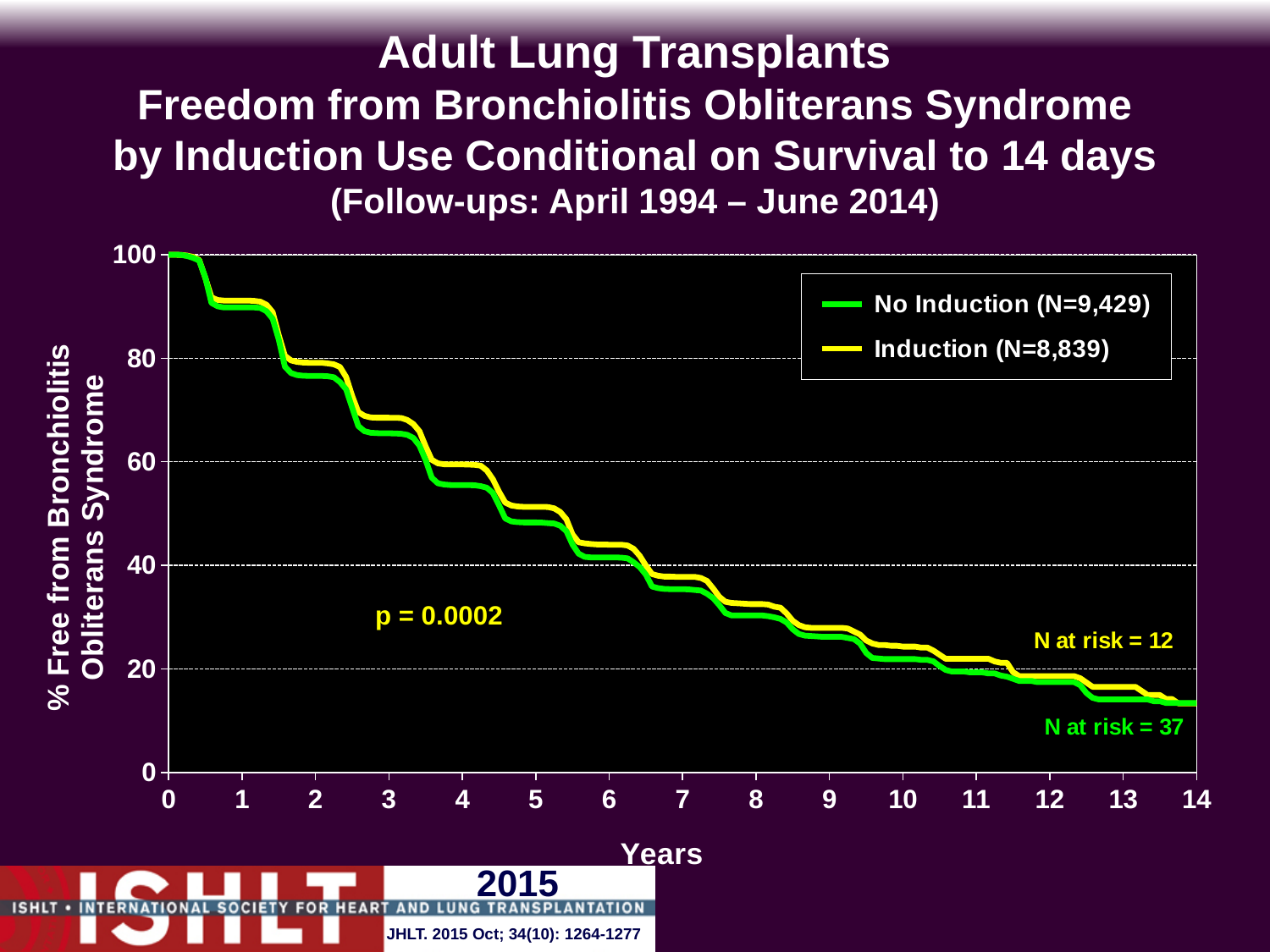
Is the value for the Induction curve at year 3 greater or less than 60? greater At year 4, which curve is higher, Induction or No Induction? Induction What is the N for the Induction group shown in the legend? 8,839 What colour is the line for the Induction group? yellow Is the value for the No Induction curve at year 7 greater or less than 40? less What is the N for the No Induction group shown in the legend? 9,429 Do the curves rise or fall as the years increase along the x axis? fall Is the value for the No Induction curve at year 13 greater or less than 20? less What kind of chart is shown on the slide? line chart How many series does the legend list? 2 What p-value is printed on the chart? p = 0.0002